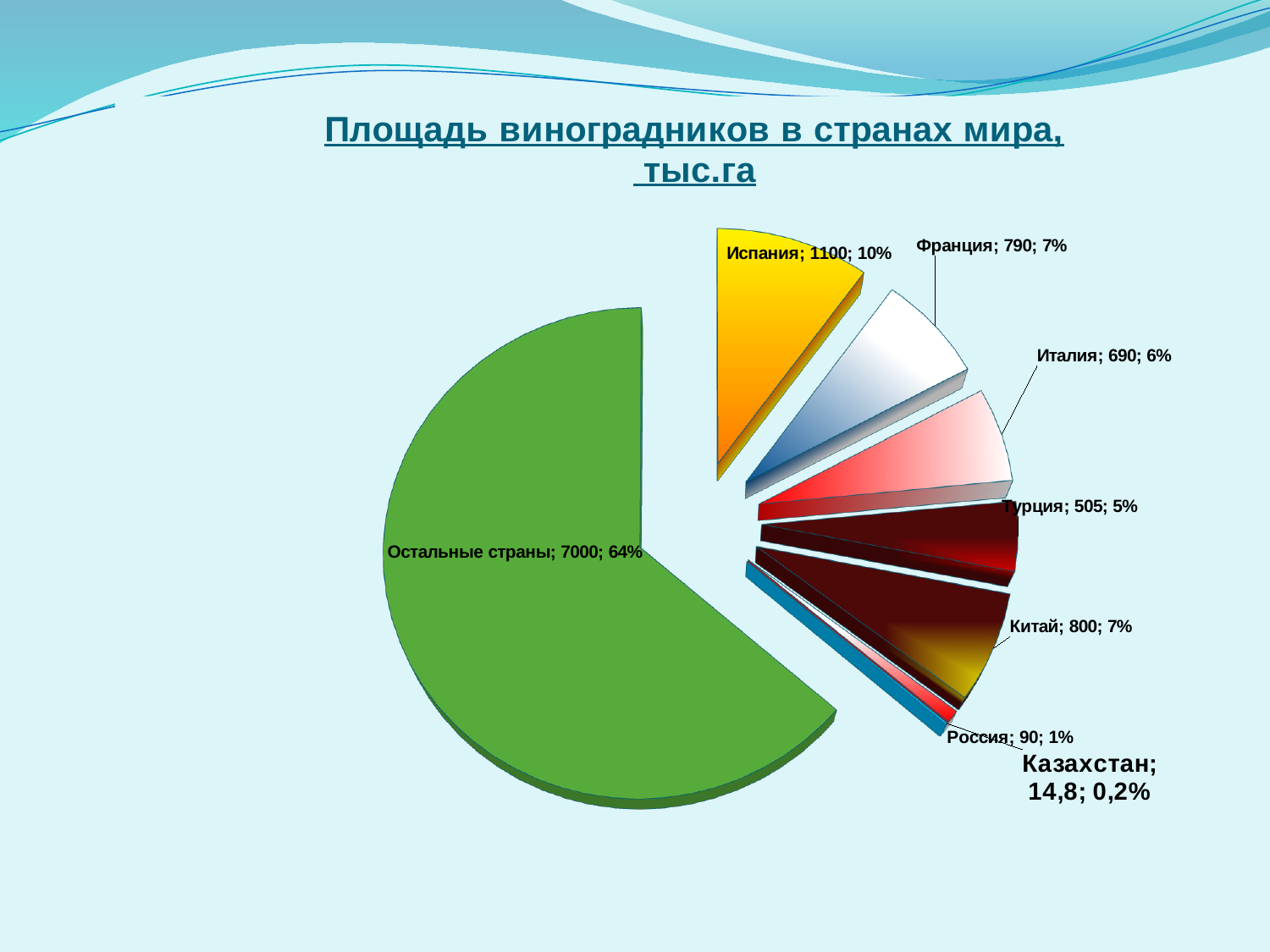
What share of the pie does Остальные страны take? 64% What is the value for Казахстан? 14,8 What is the title of the chart? Площадь виноградников в странах мира, тыс.га What is the value for Китай? 800 How many slices does the pie chart have? 8 Which is larger, the value for Китай or the value for Италия? Китай What is the value for Испания? 1100 What is the difference between the values for Испания and Франция? 310 Which category has the smallest slice? Казахстан Which category has the largest slice? Остальные страны What kind of chart is shown on the slide? pie chart What share of the pie does Турция take? 5%